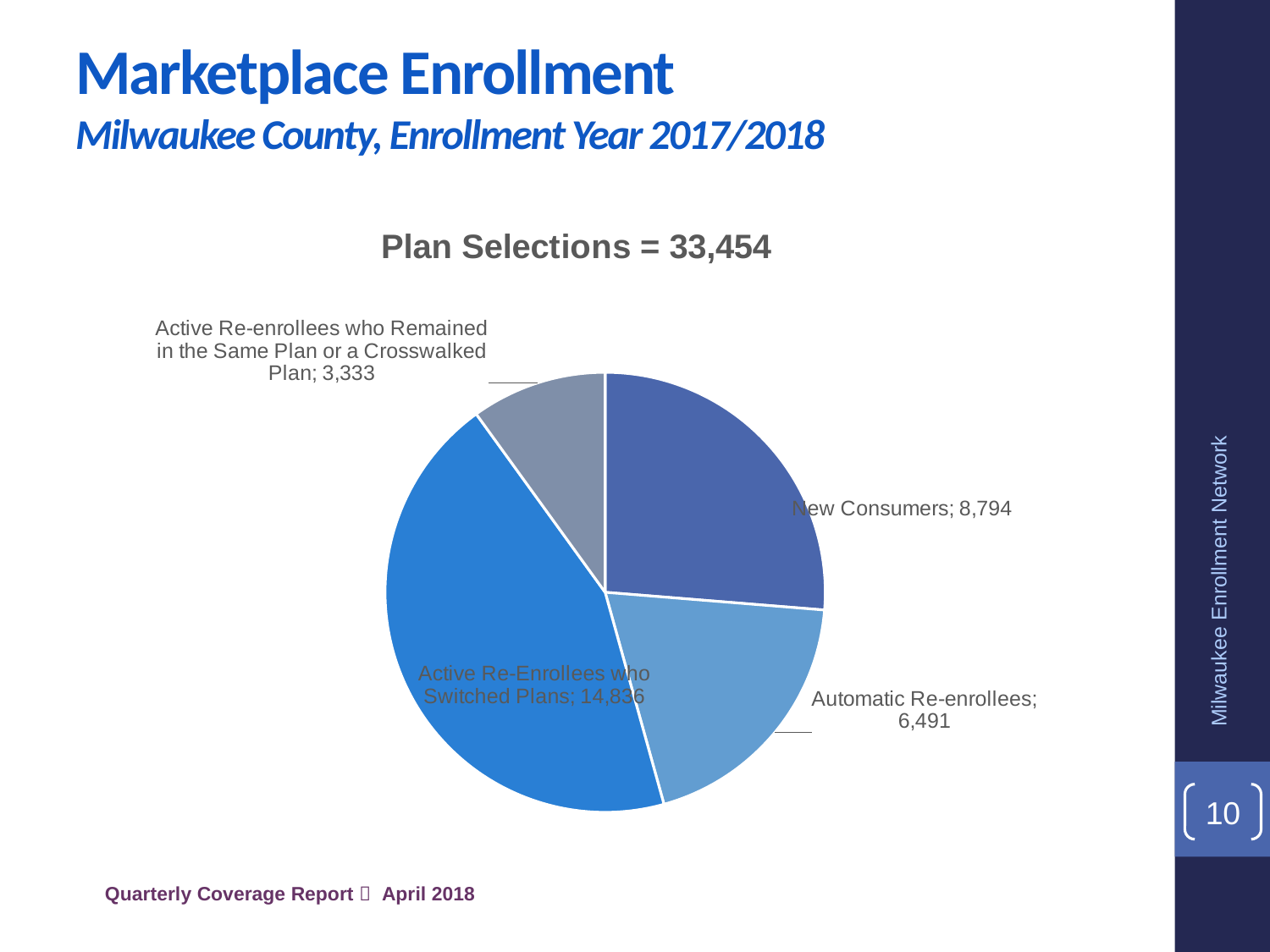
Which category has the largest slice of the pie? Active Re-Enrollees who Switched Plans What is the value for Automatic Re-enrollees? 6,491 What is the value for New Consumers? 8,794 What is the title of the chart? Plan Selections = 33,454 What is the value for Active Re-Enrollees who Switched Plans? 14,836 What is the difference between Active Re-Enrollees who Switched Plans and New Consumers? 6,042 What type of chart is shown on the slide? Pie chart How many slices does the pie chart have? 4 Which is larger, New Consumers or Automatic Re-enrollees? New Consumers What is the value for Active Re-enrollees who Remained in the Same Plan or a Crosswalked Plan? 3,333 What is the total number of plan selections shown in the chart title? 33,454 Which category has the smallest slice of the pie? Active Re-enrollees who Remained in the Same Plan or a Crosswalked Plan